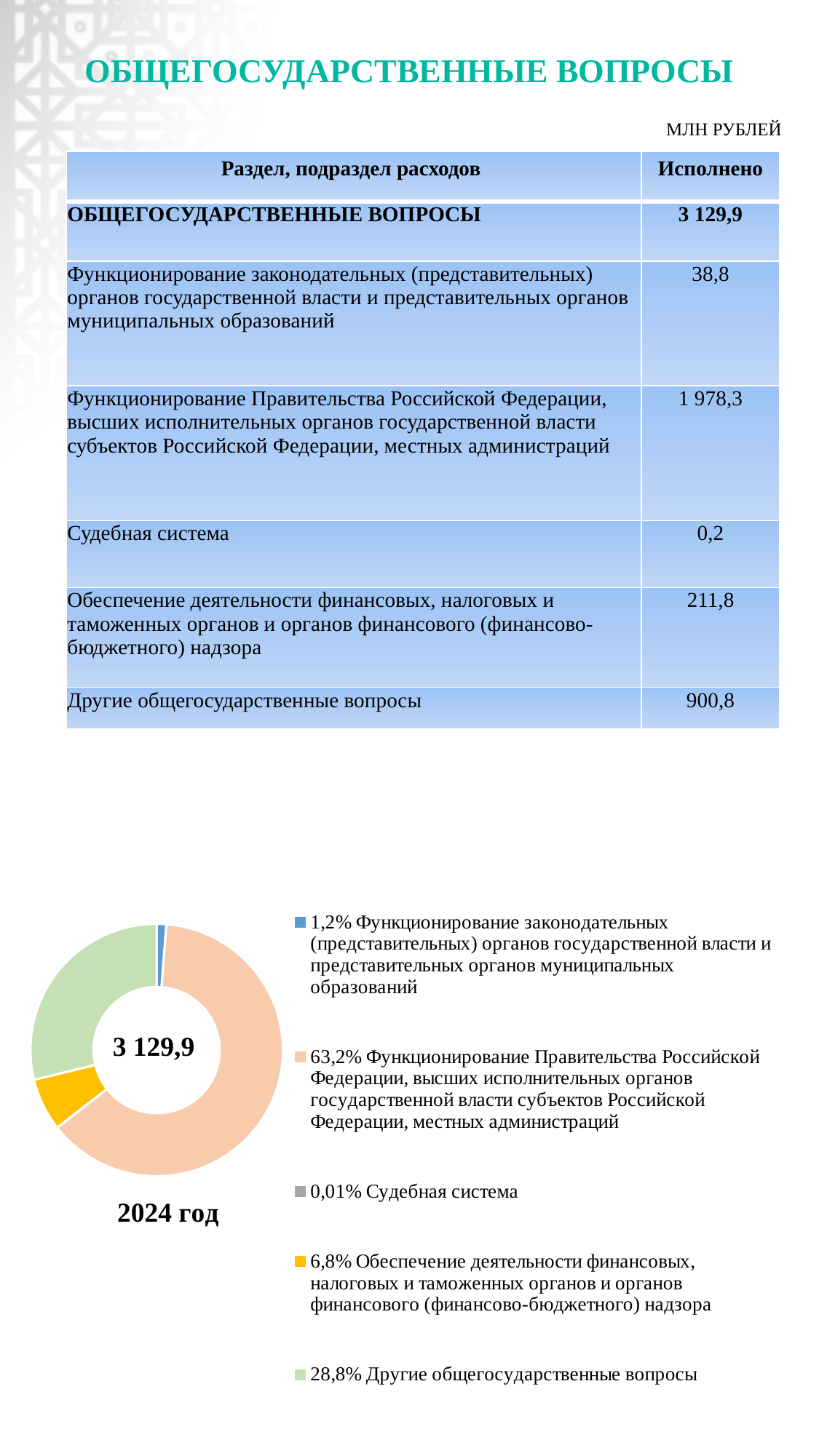
What share of the doughnut chart does "Функционирование Правительства Российской Федерации, высших исполнительных органов государственной власти субъектов Российской Федерации, местных администраций" take? 63,2% Which category has the largest share in the doughnut chart? Функционирование Правительства Российской Федерации, высших исполнительных органов государственной власти субъектов Российской Федерации, местных администраций What share of the doughnut chart does "Судебная система" take? 0,01% In the doughnut chart, which has the larger share: "Другие общегосударственные вопросы" or "Обеспечение деятельности финансовых, налоговых и таможенных органов и органов финансового (финансово-бюджетного) надзора"? Другие общегосударственные вопросы What share of the doughnut chart does "Другие общегосударственные вопросы" take? 28,8% Which category has the smallest share in the doughnut chart? Судебная система How many categories does the doughnut chart's legend list? 5 What total value is printed in the centre of the doughnut chart? 3 129,9 What kind of chart is shown on the slide? Doughnut chart Which year is labelled below the doughnut chart? 2024 год